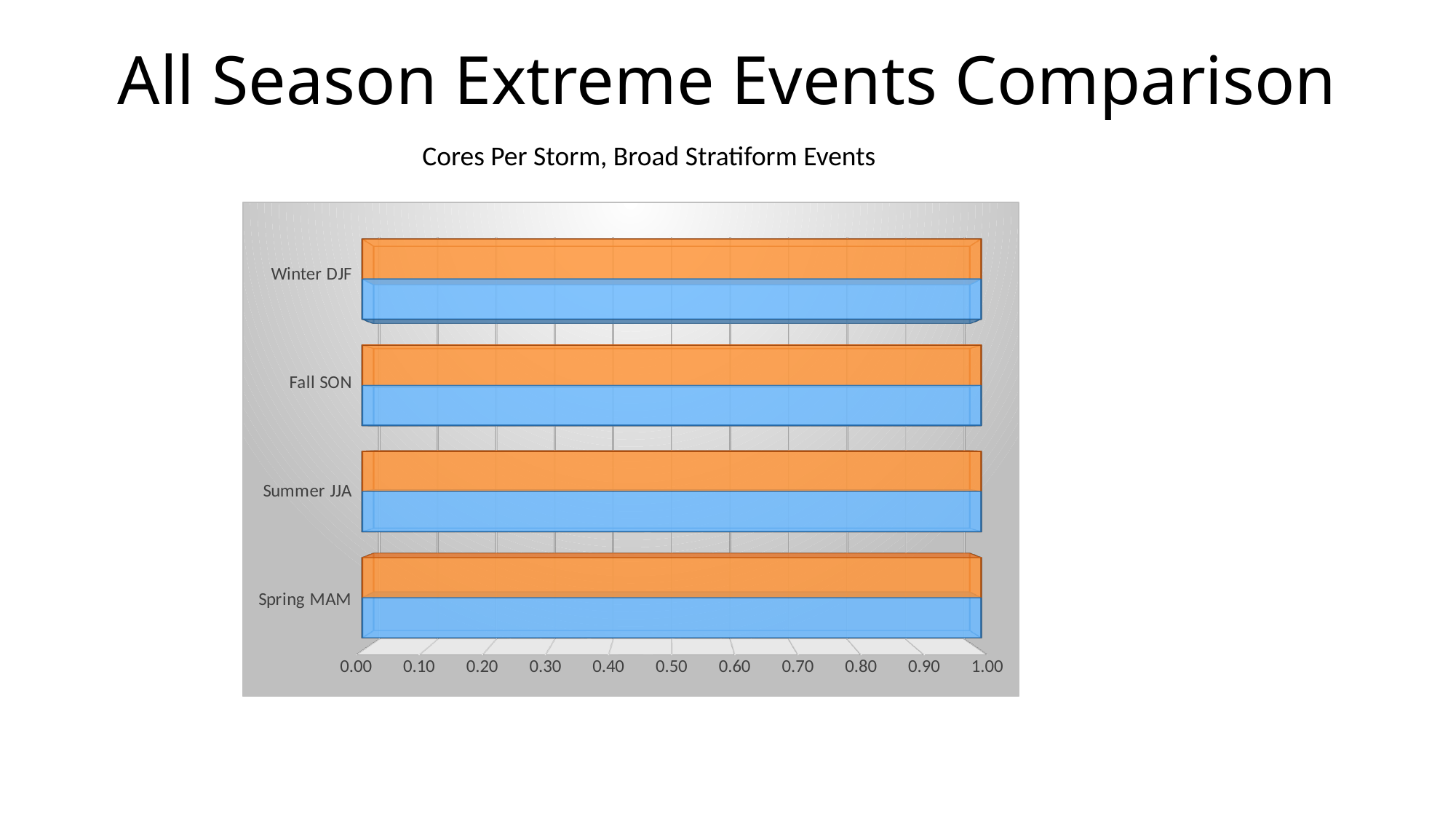
What kind of chart is shown on the slide? bar chart Which season is listed at the bottom of the chart? Spring MAM What is the maximum value shown on the horizontal axis? 1.00 Is the value of the orange bar for Winter DJF greater or less than 0.50? greater How many bars are plotted for each season? 2 Is the value of the orange bar for Summer JJA greater or less than 0.80? greater Which season is listed at the top of the chart? Winter DJF How many seasons (categories) are shown on the chart? 4 Is the value of the blue bar for Fall SON greater or less than 0.70? greater What is the title of the chart? Cores Per Storm, Broad Stratiform Events